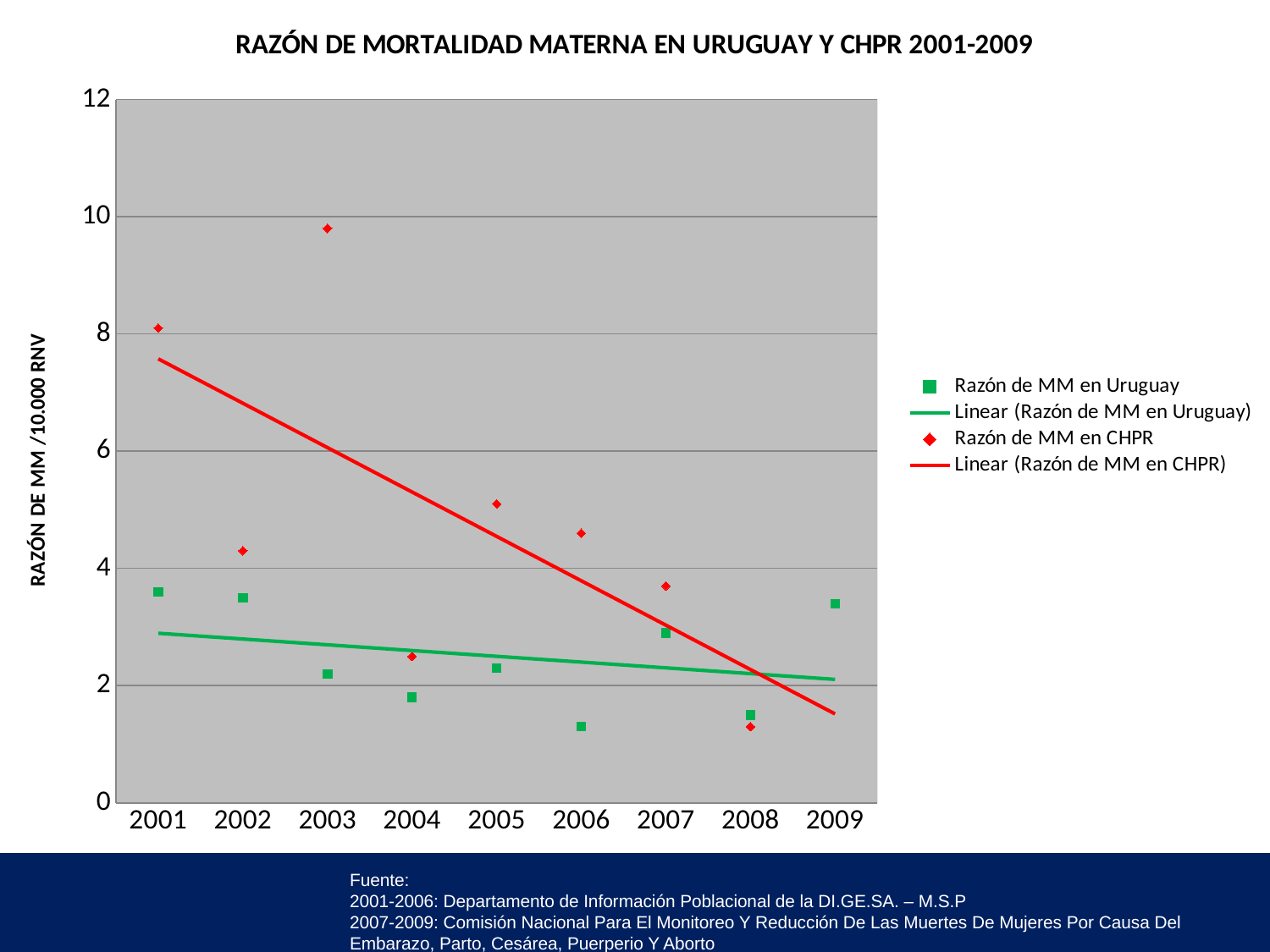
How many years are shown along the x axis? 9 In 2003, which series has the larger value: Razón de MM en Uruguay or Razón de MM en CHPR? Razón de MM en CHPR How many entries does the legend list? 4 In which year is the Razón de MM en CHPR highest? 2003 Does the linear trend line for Razón de MM en CHPR rise or fall from 2001 to 2009? Fall Is the Razón de MM en Uruguay for 2006 greater or less than 2? less What is the label of the y axis? RAZÓN DE MM /10.000 RNV Is the Razón de MM en CHPR for 2005 greater or less than 4? greater What type of chart is shown on the slide? Scatter chart Is the Razón de MM en CHPR for 2008 greater or less than 2? less What is the title of the chart? RAZÓN DE MORTALIDAD MATERNA EN URUGUAY Y CHPR 2001-2009